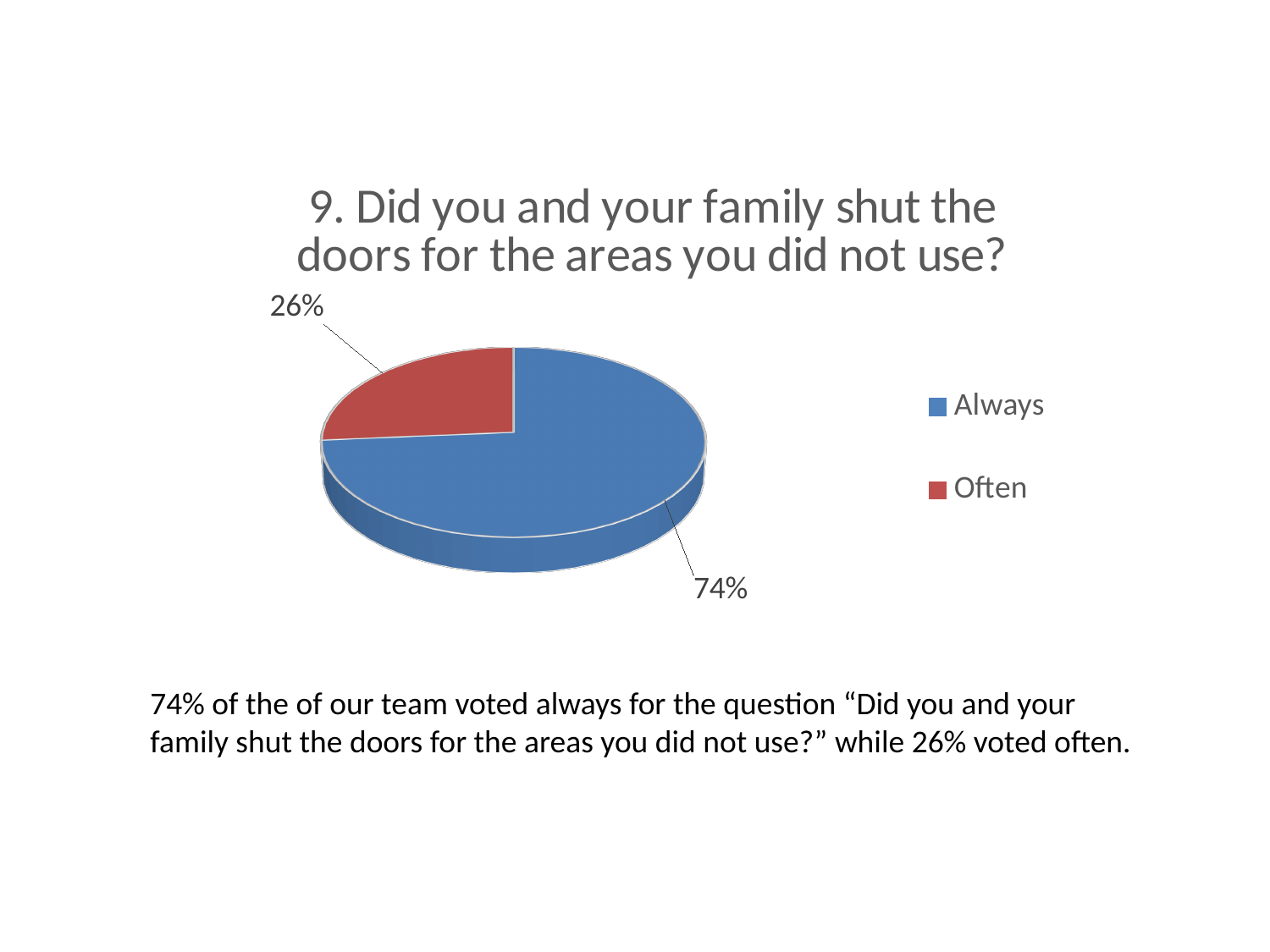
How many slices does the pie chart have? 2 What is the title of the chart? 9. Did you and your family shut the doors for the areas you did not use? Is the share for Always greater or less than 50%? greater Which slice is larger, Always or Often? Always What colour is the Often slice? Red Which category has the largest share of the pie? Always What percentage of the pie is the Often slice? 26% How many entries does the legend list? 2 Which category has the smallest share of the pie? Often What kind of chart is shown on the slide? Pie chart What is the difference in percentage points between the Always and Often slices? 48 What percentage of the pie is the Always slice? 74%